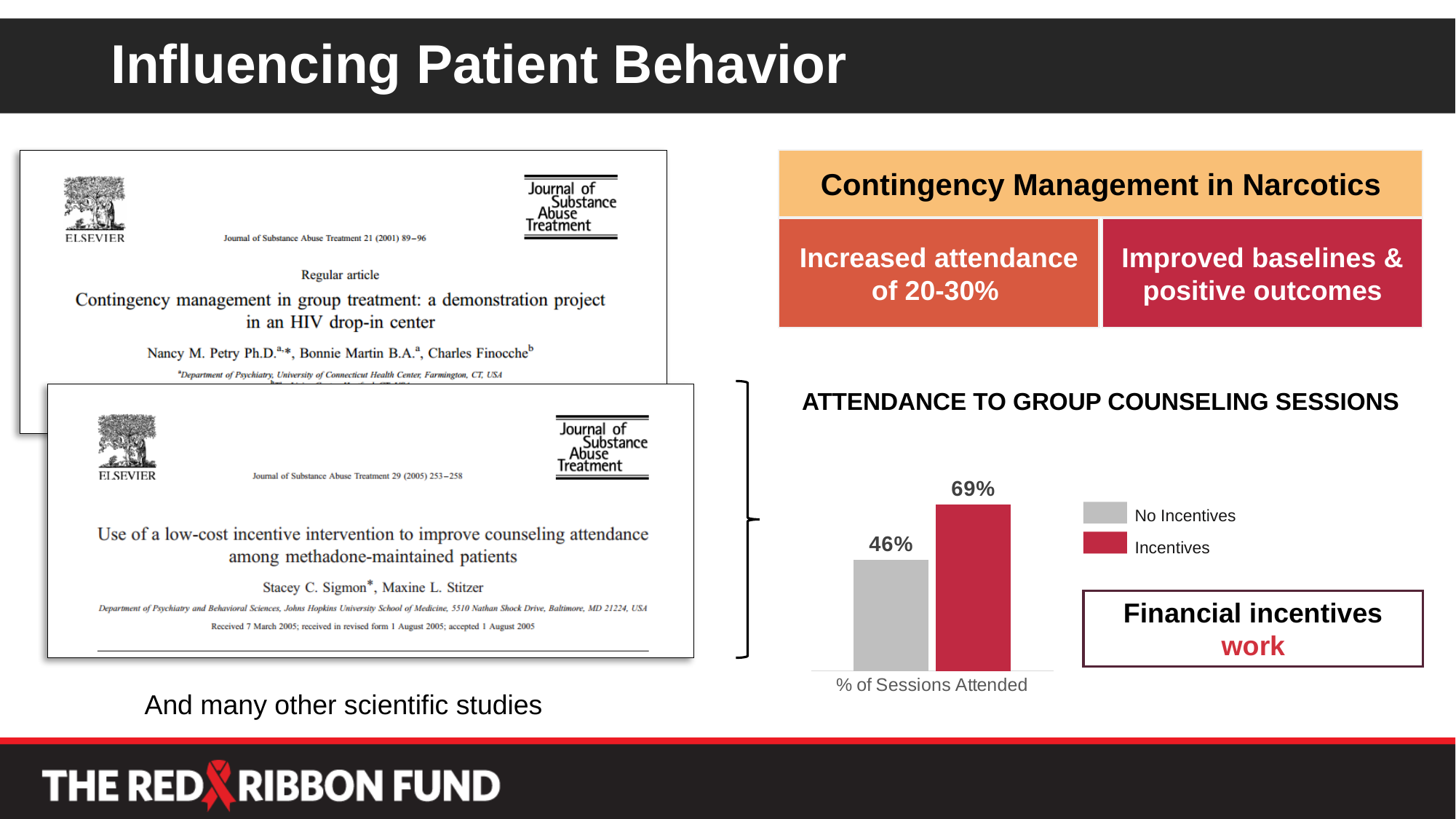
What kind of chart is used to show attendance to group counseling sessions? bar chart What is the value for No Incentives in the attendance chart? 46% What is the value for Incentives in the attendance chart? 69% Is the value for Incentives larger or smaller than the value for No Incentives? larger How many series does the legend of the attendance chart list? 2 What is the title of the chart on the slide? ATTENDANCE TO GROUP COUNSELING SESSIONS Which series has the lower percentage of sessions attended? No Incentives How many bars are plotted in the attendance chart? 2 What is the difference in percentage points between Incentives and No Incentives? 23 What colour is the Incentives bar in the chart? red Which series has the higher percentage of sessions attended? Incentives What is the axis label under the bars in the attendance chart? % of Sessions Attended